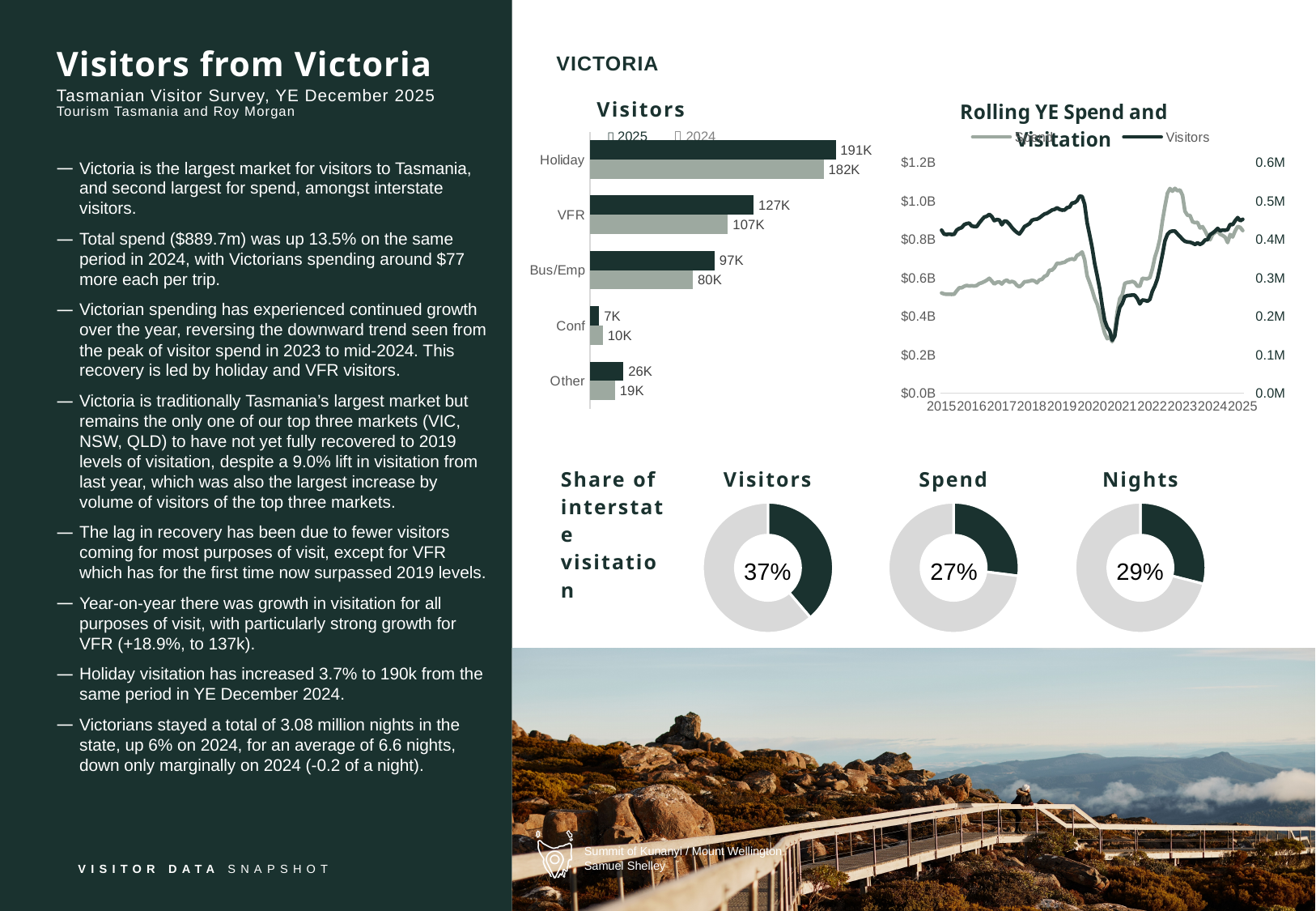
In the Visitors bar chart, which category has the highest 2025 value? Holiday In the Share of interstate visitation donut charts, what is the Spend share? 27% In the Visitors bar chart, what is the 2024 value for VFR? 107K What kind of chart is the Rolling YE Spend and Visitation chart? line chart In the Visitors bar chart, what is the 2025 value for Bus/Emp? 97K In the Share of interstate visitation donut charts, which of Visitors, Spend and Nights has the highest share? Visitors In the Visitors bar chart, what is the difference between the 2025 and 2024 values for VFR? 20K In the Visitors bar chart, what is the 2025 value for Holiday? 191K How many categories are shown in the Visitors bar chart? 5 In the Visitors bar chart, which category has the lowest 2025 value? Conf How many series does the legend of the Visitors bar chart list? 2 In the Visitors bar chart, is the 2025 value for Conf larger or smaller than the 2024 value for Conf? smaller